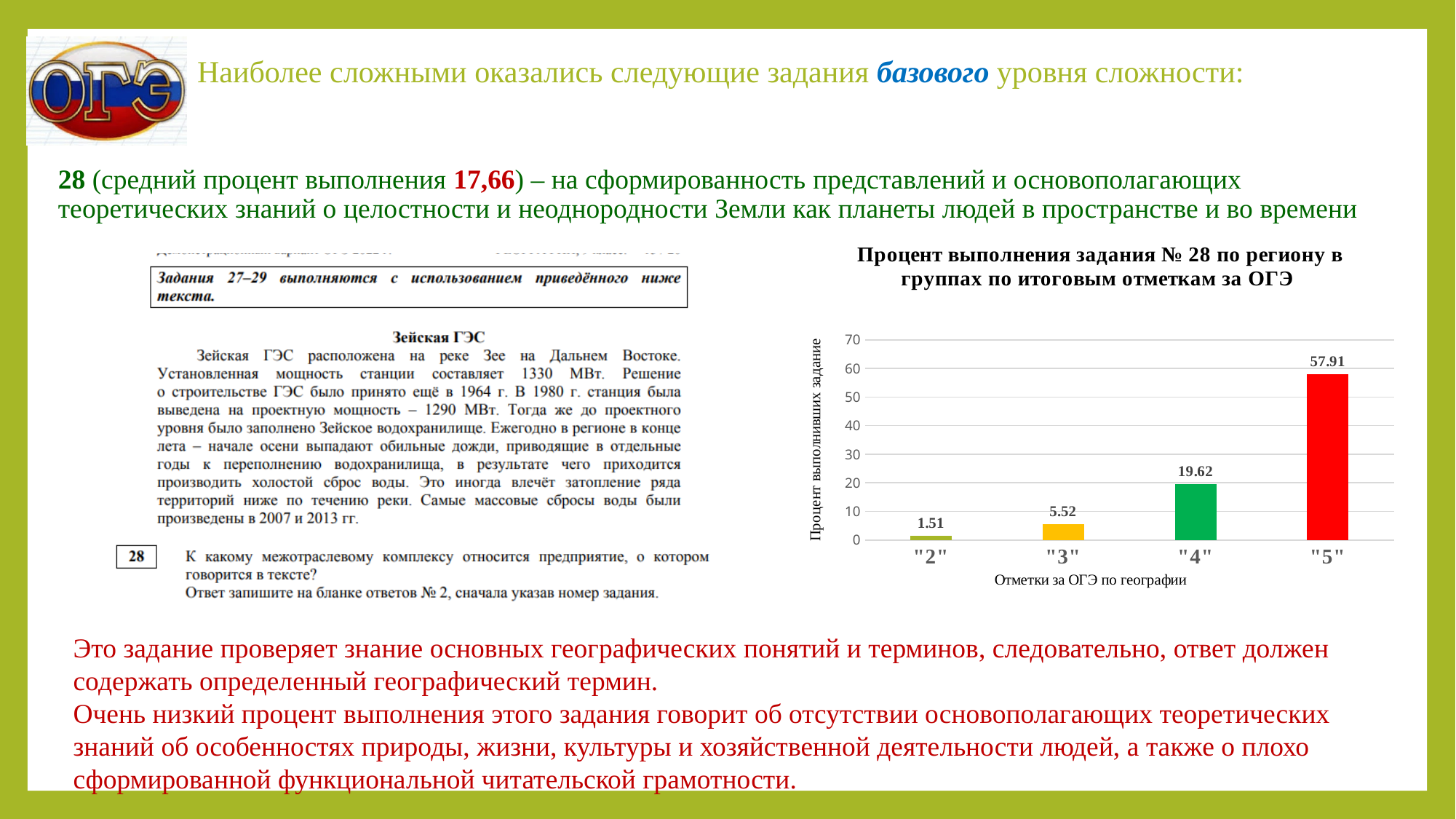
What is the difference between the values for the "3" group and the "2" group? 4.01 Which grade group has the highest percentage of students completing task 28? "5" What is the difference between the values for the "5" group and the "4" group? 38.29 What kind of chart is shown on the slide? Bar chart What is the value for the "2" group in the chart? 1.51 Which grade group has the lowest percentage of students completing task 28? "2" What is the value for the "4" group in the chart? 19.62 What is the value for the "5" group in the chart? 57.91 What is the value for the "3" group in the chart? 5.52 Which is larger, the value for the "4" group or the "3" group? "4" Do the values rise or fall as the grade increases from "2" to "5"? Rise How many grade groups are shown on the x axis of the chart? 4